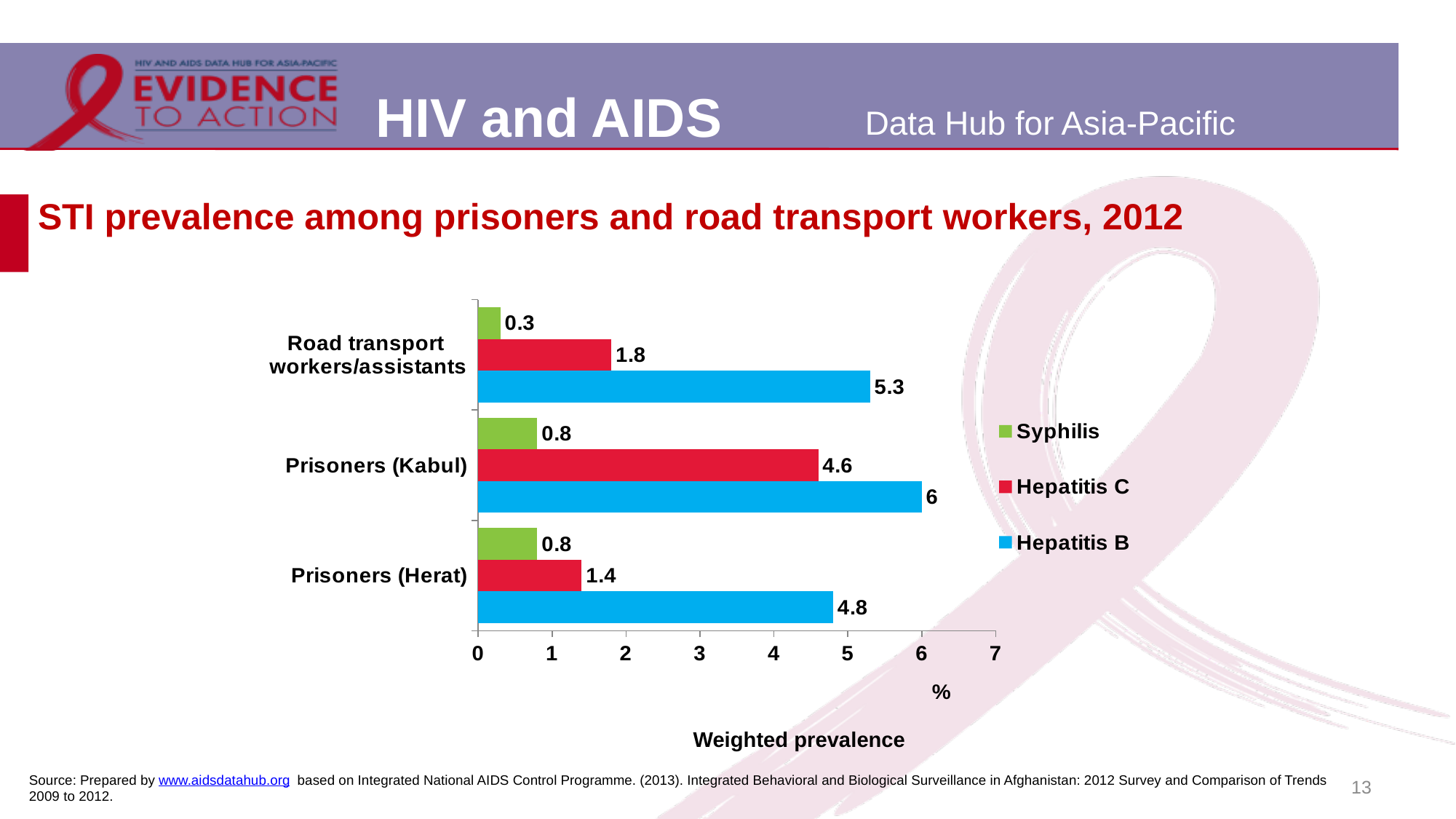
What is the Hepatitis C prevalence among Road transport workers/assistants? 1.8 How many series does the legend list? 3 What is the Hepatitis B prevalence among Prisoners (Kabul)? 6 What is the Syphilis prevalence among Prisoners (Herat)? 0.8 Which group has the lowest Syphilis prevalence? Road transport workers/assistants Which group has the highest Hepatitis B prevalence? Prisoners (Kabul) What is the difference between the Hepatitis C prevalence among Prisoners (Kabul) and Prisoners (Herat)? 3.2 How many groups are shown on the chart? 3 Is the Hepatitis C prevalence among Prisoners (Kabul) greater or less than 4? greater What kind of chart is shown on the slide? Bar chart What is the label on the horizontal axis of the chart? % Which is larger: Hepatitis B prevalence among Road transport workers/assistants or among Prisoners (Herat)? Road transport workers/assistants